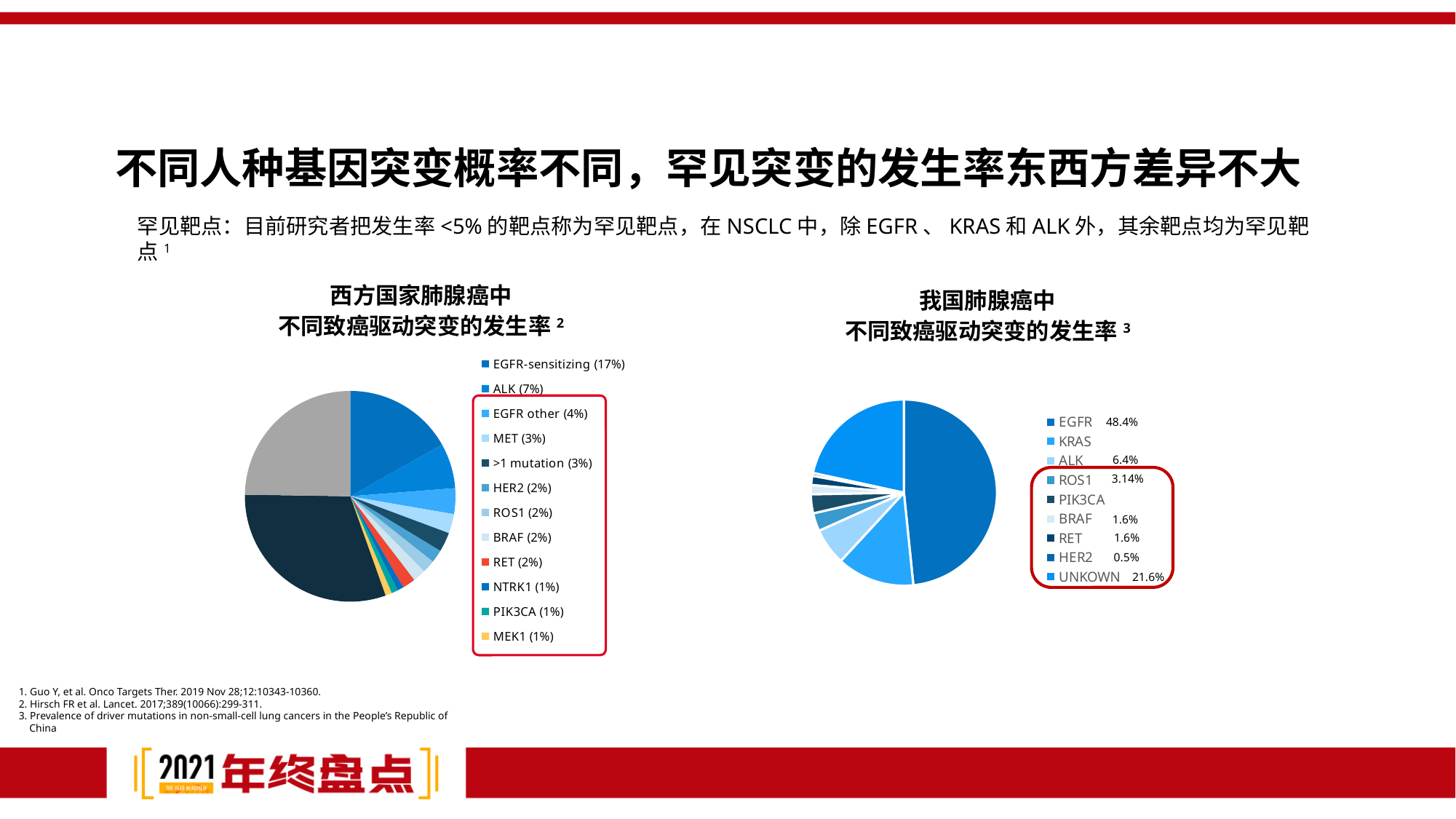
In the left pie chart (西方国家肺腺癌中不同致癌驱动突变的发生率), which is larger, ALK or EGFR other? ALK In the right pie chart (我国肺腺癌中不同致癌驱动突变的发生率), what is the difference between the EGFR value and the UNKOWN value? 26.8% In the left pie chart (西方国家肺腺癌中不同致癌驱动突变的发生率), what is the value shown for ALK? 7% In the right pie chart (我国肺腺癌中不同致癌驱动突变的发生率), what is the value shown for EGFR? 48.4% In the right pie chart (我国肺腺癌中不同致癌驱动突变的发生率), which category has the largest slice? EGFR In the left pie chart (西方国家肺腺癌中不同致癌驱动突变的发生率), what is the value shown for MET? 3% In the left pie chart (西方国家肺腺癌中不同致癌驱动突变的发生率), which legend entry has the highest printed value? EGFR-sensitizing (17%) How many entries does the legend of the left pie chart (西方国家肺腺癌中不同致癌驱动突变的发生率) list? 12 In the right pie chart (我国肺腺癌中不同致癌驱动突变的发生率), what is the value shown for UNKOWN? 21.6% In the left pie chart (西方国家肺腺癌中不同致癌驱动突变的发生率), what is the value shown for EGFR-sensitizing? 17% What type of chart is used on this slide to show the mutation rates? Pie chart In the right pie chart (我国肺腺癌中不同致癌驱动突变的发生率), what is the value shown for ROS1? 3.14%